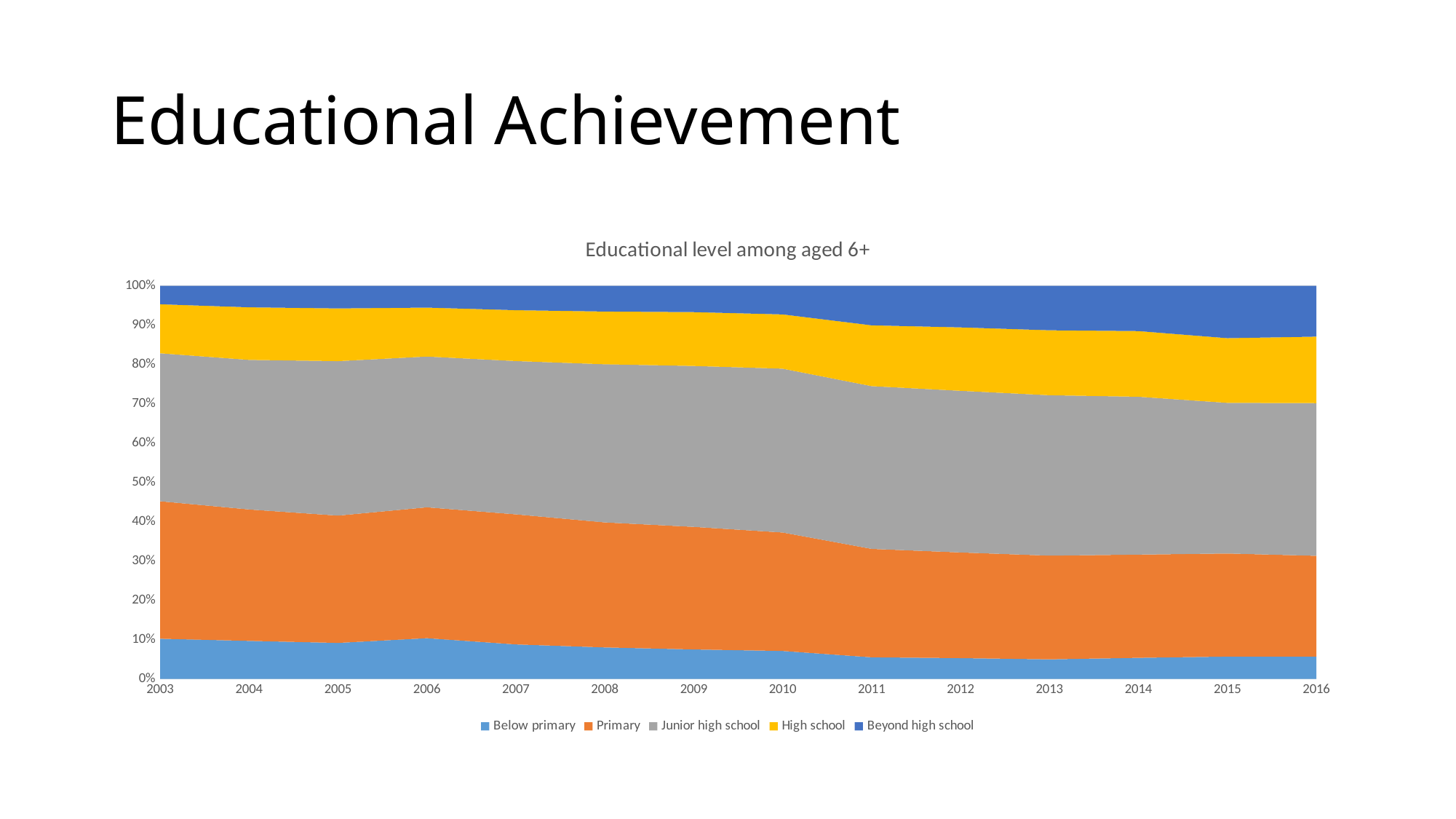
Does the share of Below primary rise or fall from 2003 to 2016? Fall Does the share of Beyond high school rise or fall from 2003 to 2016? Rise Is the value for Beyond high school in 2016 greater or less than 10%? greater What kind of chart is shown on the slide? Stacked area chart How many years are shown along the x axis? 14 How many series does the legend list? 5 Does the share of Primary rise or fall from 2003 to 2016? Fall Which educational level has the largest share in 2016? Junior high school What is the title of the chart? Educational level among aged 6+ Which series is shown in yellow in the legend? High school Is the value for Below primary in 2016 greater or less than 10%? less In 2016, which is larger: the share of Junior high school or the share of High school? Junior high school